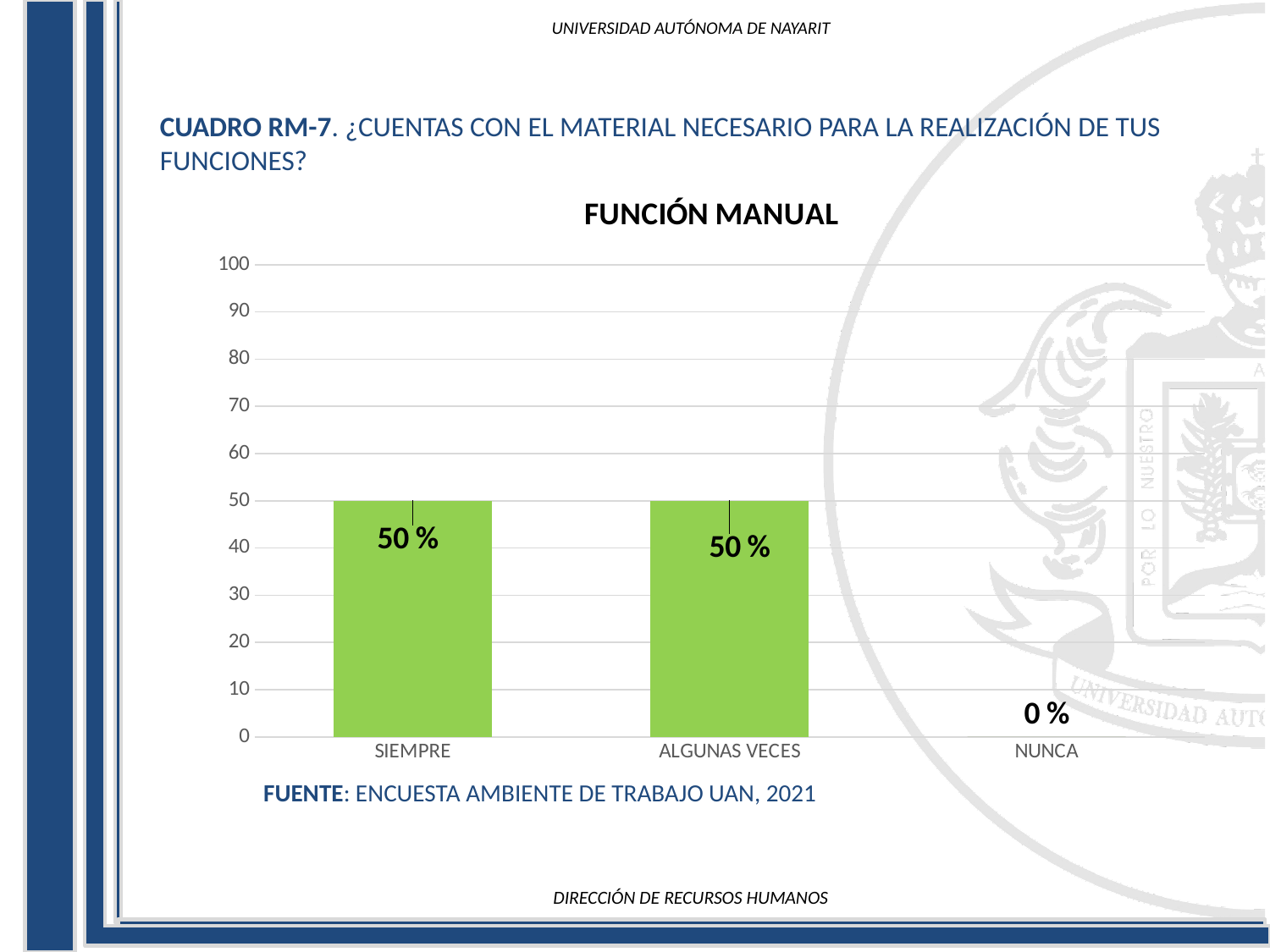
What kind of chart is shown on the slide? bar chart Which category has the lowest value? NUNCA What is the title of the chart? FUNCIÓN MANUAL What is the value for SIEMPRE? 50 % How many categories are shown on the x axis? 3 What is the difference between the values for SIEMPRE and NUNCA? 50 % What is the highest value shown on the y axis? 100 Is the value for ALGUNAS VECES greater or less than 40? greater What is the value for NUNCA? 0 % Which is larger, the value for ALGUNAS VECES or the value for NUNCA? ALGUNAS VECES What is the value for ALGUNAS VECES? 50 % Is the value for SIEMPRE greater or less than 60? less